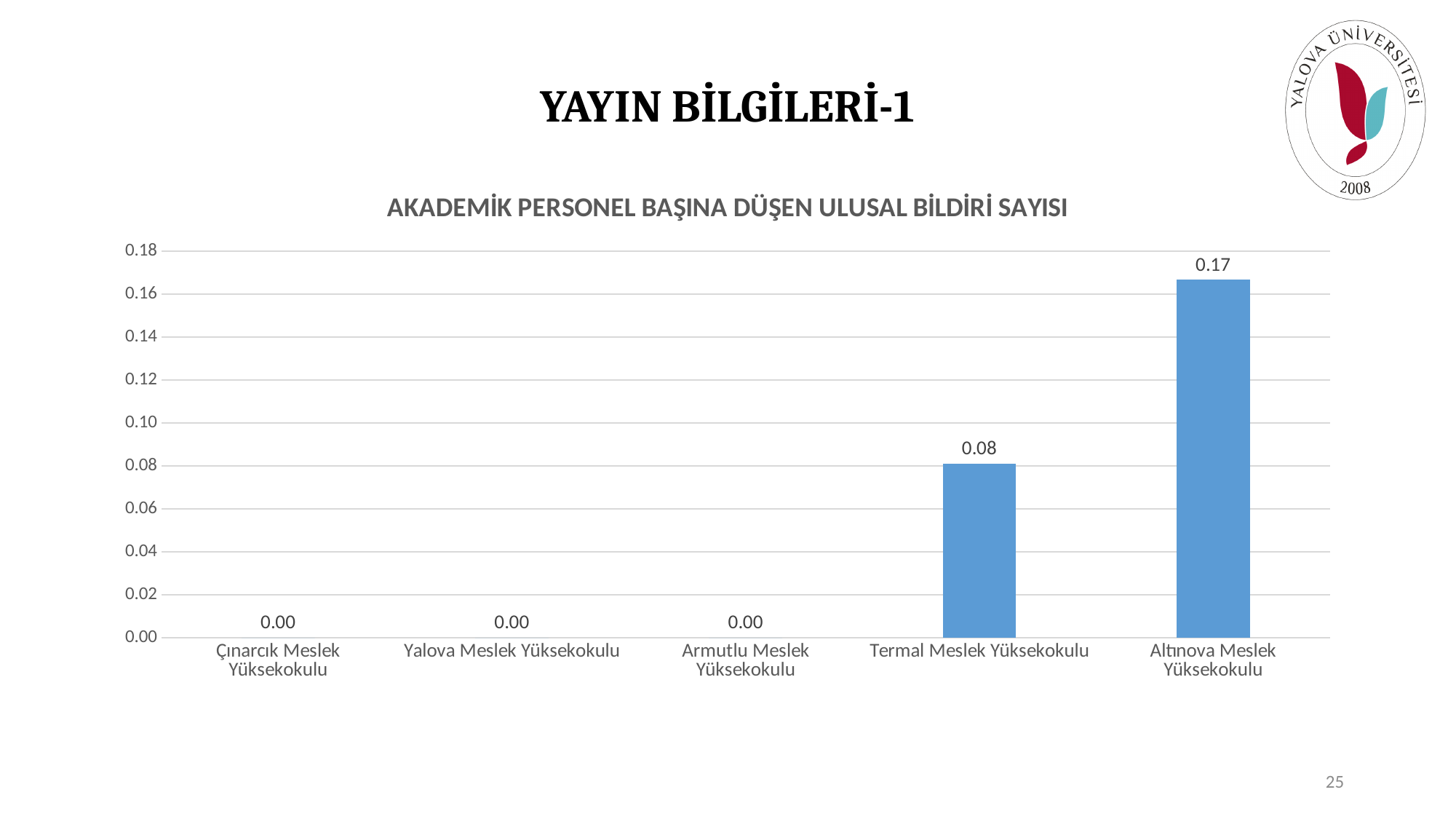
What is the value for Termal Meslek Yüksekokulu? 0.08 How many categories have a value of 0.00? 3 What is the value for Çınarcık Meslek Yüksekokulu? 0.00 What is the difference between the values for Altınova Meslek Yüksekokulu and Termal Meslek Yüksekokulu? 0.09 What is the value for Yalova Meslek Yüksekokulu? 0.00 Which is larger, the value for Termal Meslek Yüksekokulu or the value for Altınova Meslek Yüksekokulu? Altınova Meslek Yüksekokulu What kind of chart is shown on the slide? bar chart Which category has the highest value? Altınova Meslek Yüksekokulu Is the value for Altınova Meslek Yüksekokulu greater or less than 0.10? greater What is the title of the chart? AKADEMİK PERSONEL BAŞINA DÜŞEN ULUSAL BİLDİRİ SAYISI What is the value for Altınova Meslek Yüksekokulu? 0.17 How many categories are shown on the x axis? 5